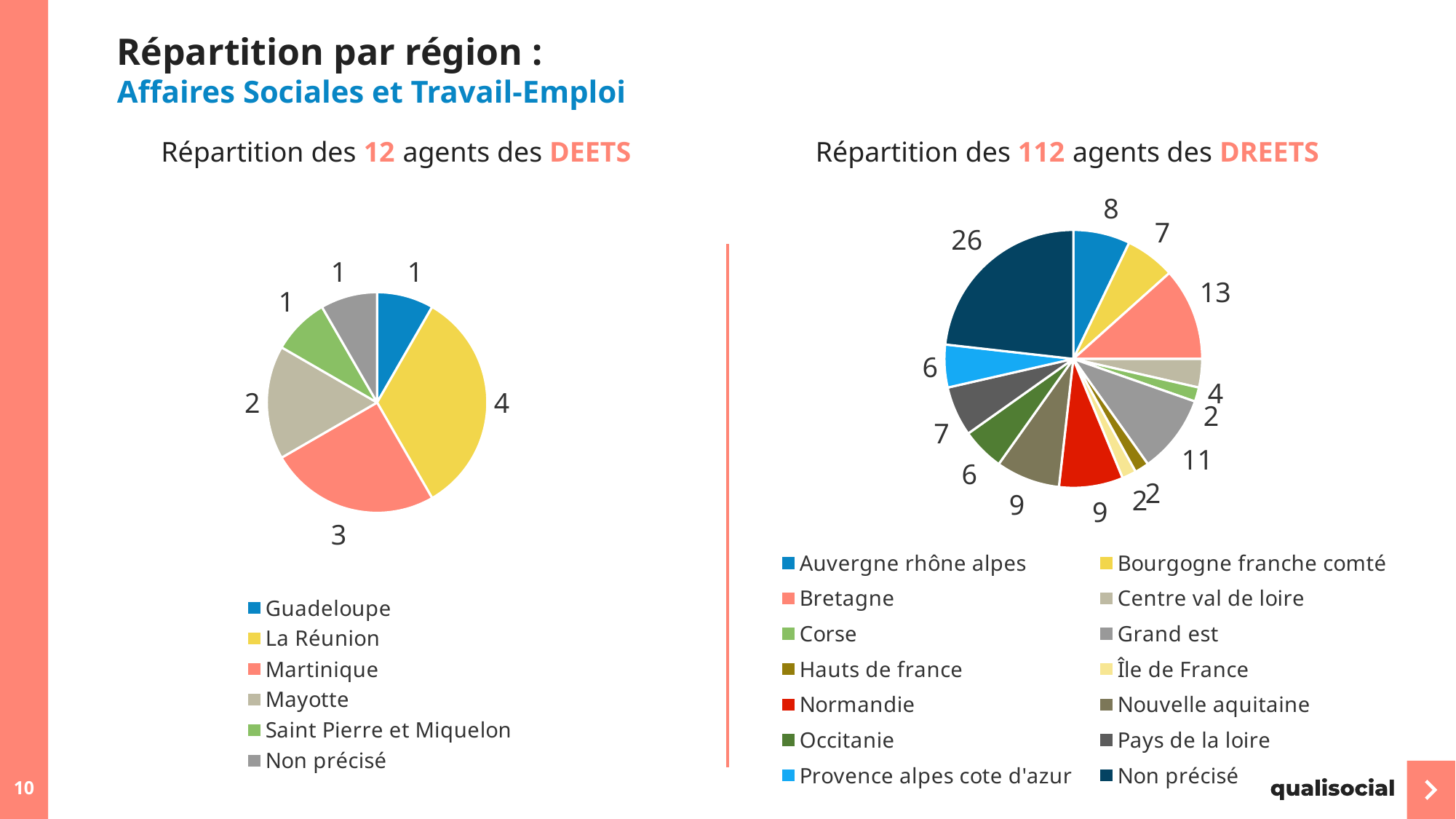
What type of chart is used on this slide? Pie chart In the DEETS pie chart on the left, what is the difference between Martinique and Mayotte? 1 In the DREETS pie chart on the right, how many categories does the legend list? 14 In the DEETS pie chart on the left, how many categories does the legend list? 6 In the DEETS pie chart on the left, what is the value for La Réunion? 4 In the DREETS pie chart on the right, which is larger, Auvergne rhône alpes or Bourgogne franche comté? Auvergne rhône alpes In the DREETS pie chart on the right, which category has the largest slice? Non précisé In the DREETS pie chart on the right, what is the value for Bretagne? 13 In the DREETS pie chart on the right, what is the difference between Non précisé and Bretagne? 13 In the DEETS pie chart on the left, what share of the 12 agents does La Réunion represent? 4 out of 12 (one third) In the DEETS pie chart on the left, which region has the largest slice? La Réunion In the DREETS pie chart on the right, what is the value for Grand est? 11